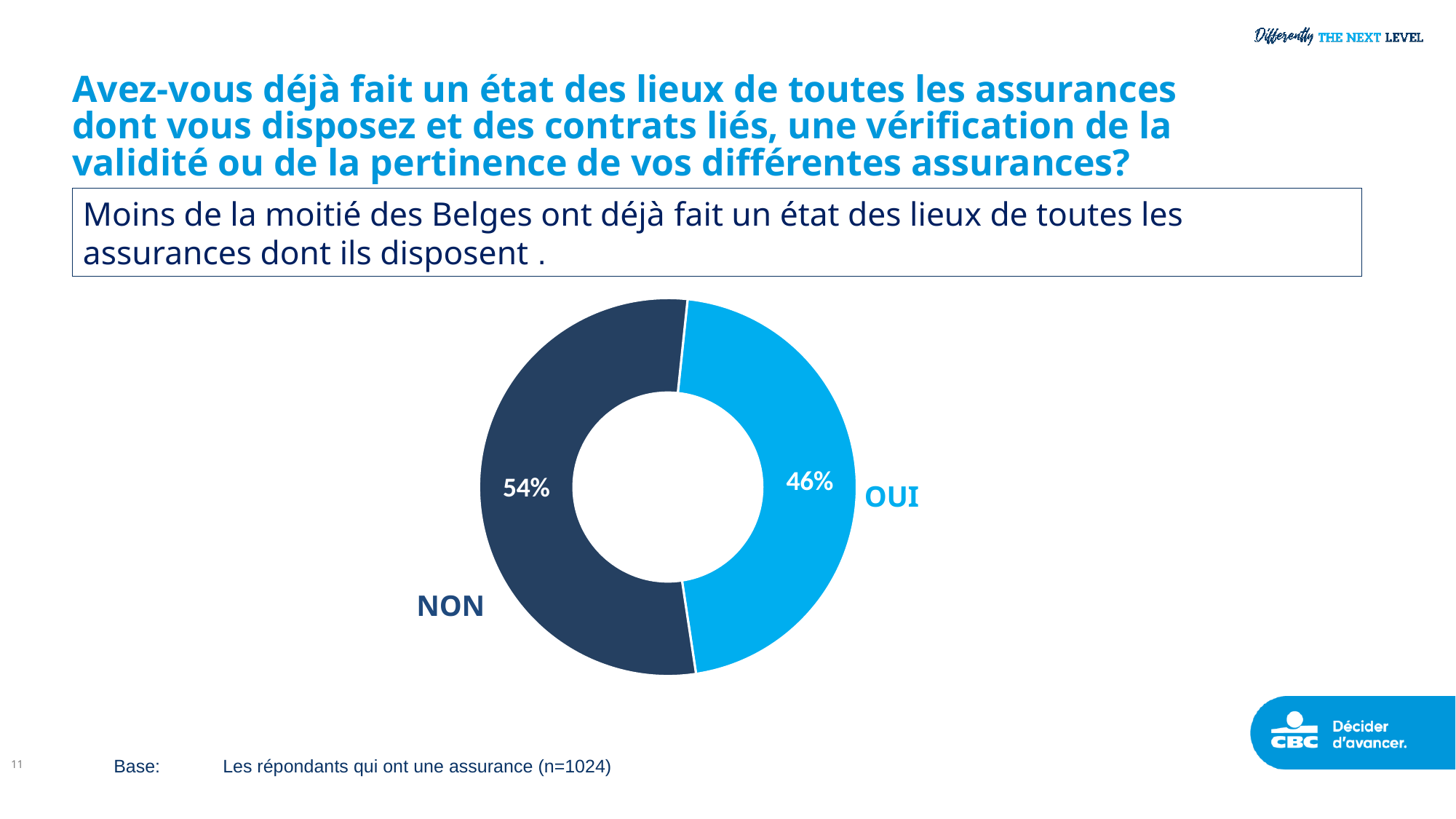
What percentage of respondents answered OUI? 46% Is the share for OUI greater or less than 50%? less Which response has the larger share, OUI or NON? NON What kind of chart is shown on the slide? Doughnut (pie) chart What percentage of respondents answered NON? 54% What is the base (n) of respondents stated below the chart? n=1024 What colour is the OUI slice? Light blue Which category has the smallest share of the chart? OUI What share of the chart does the NON slice represent? 54% What is the difference in percentage points between the NON and OUI shares? 8 How many categories are shown in the chart? 2 Which category has the largest share of the chart? NON